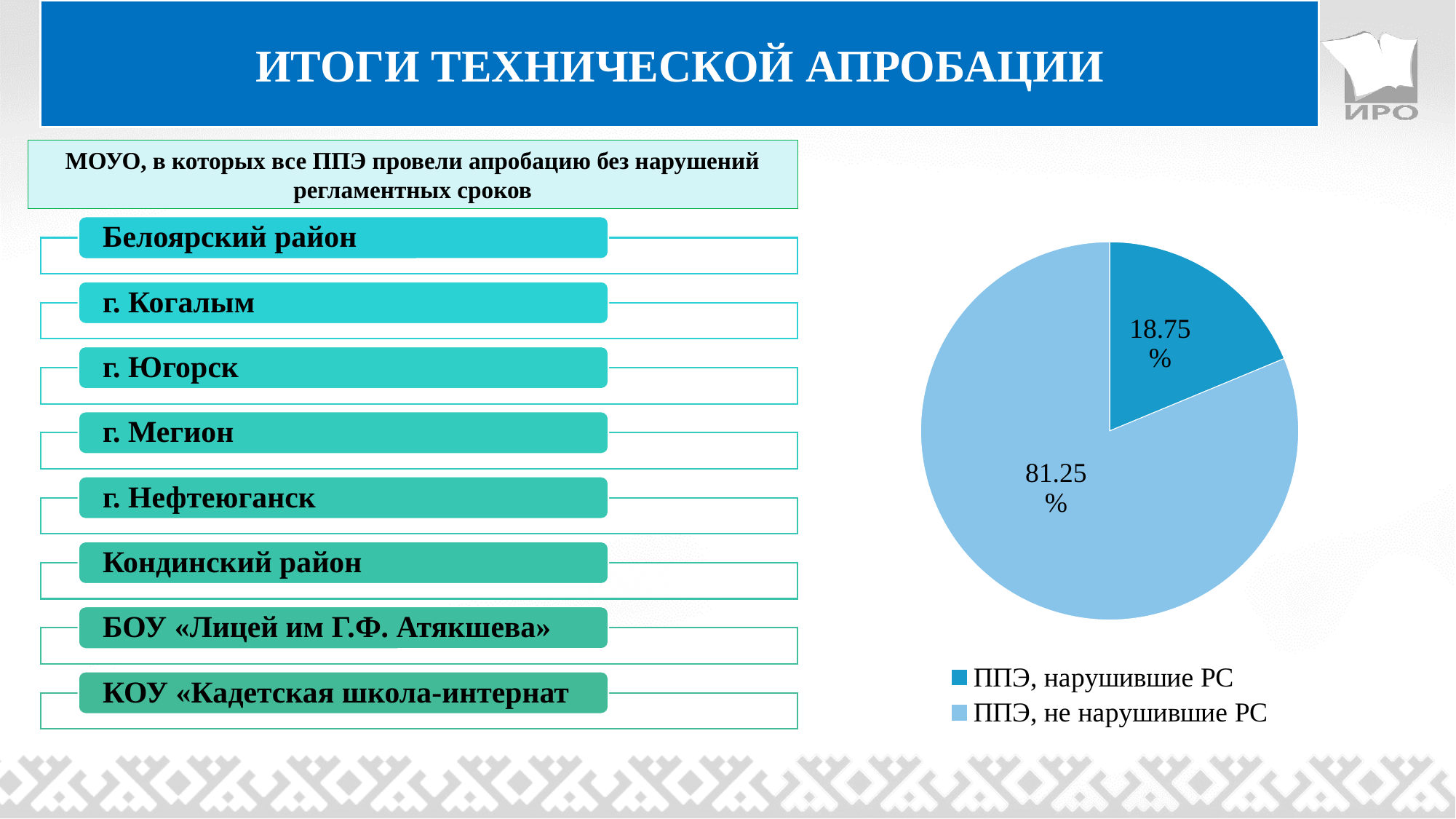
Is the share for "ППЭ, нарушившие РС" greater or less than 20%? less How many entries does the legend of the pie chart list? 2 Which slice of the pie chart is the largest? ППЭ, не нарушившие РС How many slices does the pie chart have? 2 In the pie chart, what share is shown for "ППЭ, нарушившие РС"? 18.75% What kind of chart is shown on the right side of the slide? pie chart Which slice of the pie chart is the smallest? ППЭ, нарушившие РС What is the title of the slide containing the pie chart? ИТОГИ ТЕХНИЧЕСКОЙ АПРОБАЦИИ Which is larger in the pie chart: "ППЭ, нарушившие РС" or "ППЭ, не нарушившие РС"? ППЭ, не нарушившие РС What is the difference in percentage points between the "ППЭ, не нарушившие РС" slice and the "ППЭ, нарушившие РС" slice? 62.5 In the pie chart, what share is shown for "ППЭ, не нарушившие РС"? 81.25% Which legend entry of the pie chart is shown in the darker blue colour? ППЭ, нарушившие РС